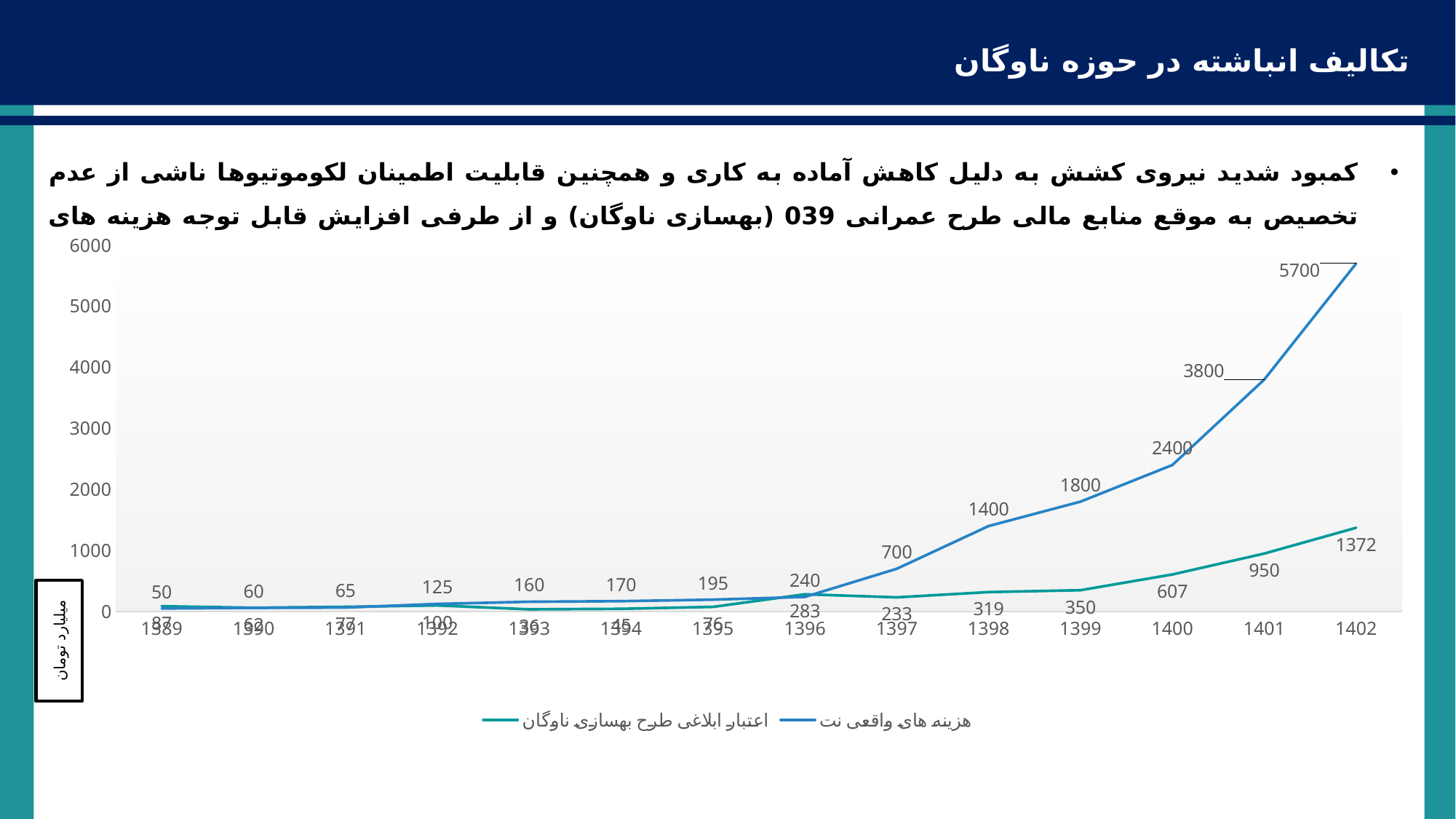
What is the value of اعتبار ابلاغی طرح بهسازی ناوگان in 1400? 607 In which year is هزینه های واقعی نت highest? 1402 How many series does the legend list? 2 What is the value of هزینه های واقعی نت in 1402? 5700 What is the value of اعتبار ابلاغی طرح بهسازی ناوگان in 1401? 950 Does هزینه های واقعی نت rise or fall from 1396 to 1402? rise What is the difference between هزینه های واقعی نت and اعتبار ابلاغی طرح بهسازی ناوگان in 1402? 4328 Which series has the larger value in 1399, هزینه های واقعی نت or اعتبار ابلاغی طرح بهسازی ناوگان? هزینه های واقعی نت How many years are plotted along the x axis? 14 What kind of chart is shown on the slide? line chart What is the value of هزینه های واقعی نت in 1398? 1400 What unit is shown on the y axis label? میلیارد تومان